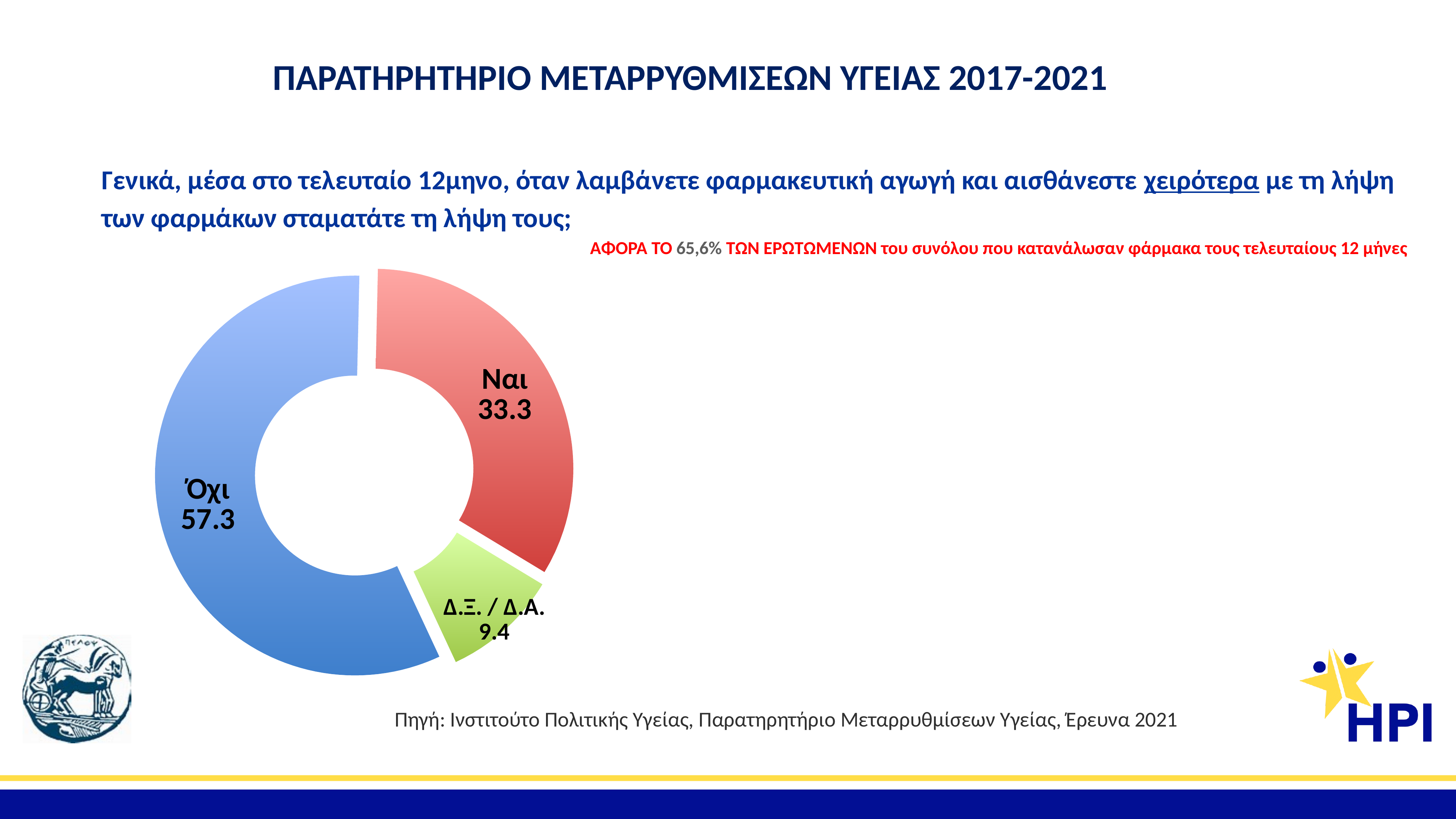
What kind of chart is shown on the slide? Doughnut (pie) chart How many slices does the chart have? 3 What value is shown for the "Ναι" slice? 33.3 Which is larger, the value for "Ναι" or the value for "Όχι"? Όχι What colour is the "Όχι" slice? Blue What is the difference between the values for "Ναι" and "Δ.Ξ. / Δ.Α."? 23.9 What value is shown for the "Όχι" slice? 57.3 Which category has the largest slice? Όχι What value is shown for the "Δ.Ξ. / Δ.Α." slice? 9.4 What colour is the "Ναι" slice? Red What is the difference between the values for "Όχι" and "Ναι"? 24.0 Which category has the smallest slice? Δ.Ξ. / Δ.Α.